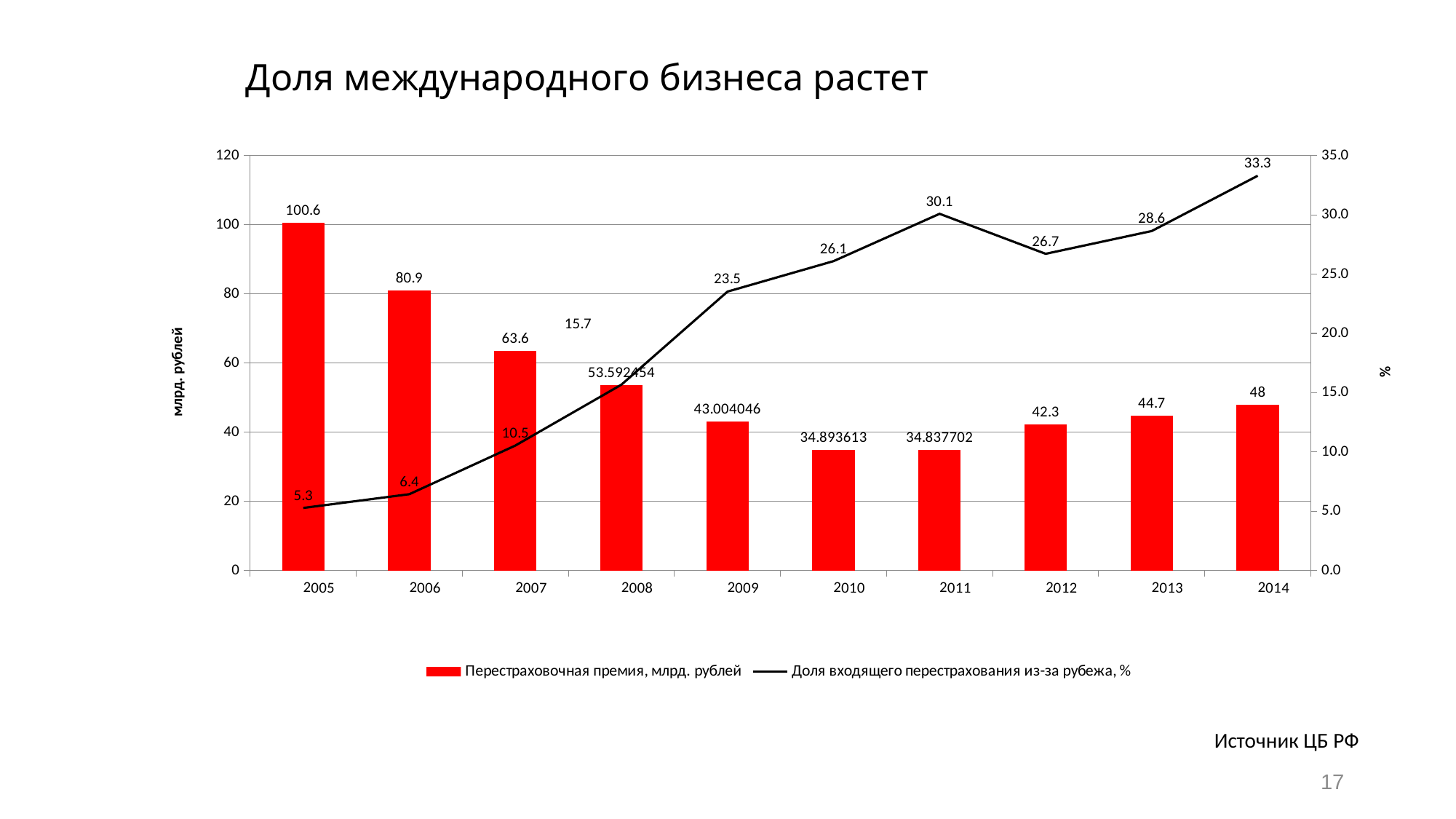
Which year has the highest value of Перестраховочная премия, млрд. рублей? 2005 Which is larger, the Перестраховочная премия, млрд. рублей value for 2013 or for 2014? 2014 What is the value of Доля входящего перестрахования из-за рубежа, % for 2014? 33.3 How many years are shown on the x axis? 10 Which year has the lowest value of Доля входящего перестрахования из-за рубежа, %? 2005 Does the Доля входящего перестрахования из-за рубежа, % line generally rise or fall from 2005 to 2014? Rise What is the value of Перестраховочная премия, млрд. рублей for 2010? 34.893613 What kind of chart is shown on the slide? Combined bar and line chart How many series does the legend list? 2 What is the value of Перестраховочная премия, млрд. рублей for 2005? 100.6 What is the difference between the Доля входящего перестрахования из-за рубежа, % values for 2011 and 2012? 3.4 What is the difference between the Перестраховочная премия, млрд. рублей values for 2005 and 2006? 19.7